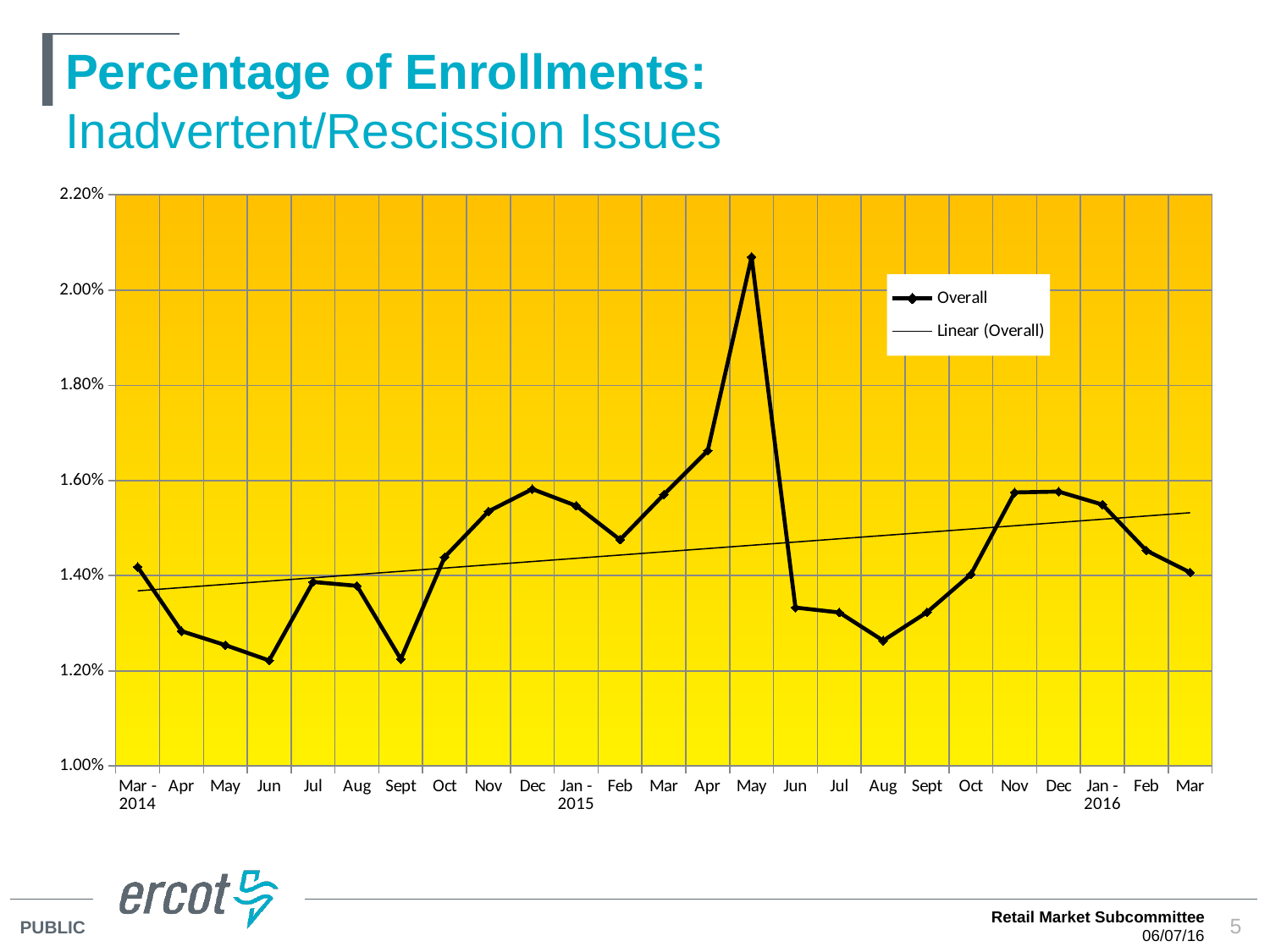
How many monthly data points are plotted on the Overall line? 25 Is the Overall value for Aug 2015 greater or less than 1.40%? less Which is larger, the Overall value for Apr 2015 or for Jun 2015? Apr 2015 How many series does the legend list? 2 Is the Overall value for Apr 2015 greater or less than 1.60%? greater In which month does the Overall line reach its highest value? May 2015 Does the Linear (Overall) trend line rise or fall from left to right? Rises What are the two entries in the chart legend? Overall and Linear (Overall) What kind of chart is shown on the slide? Line chart Is the Overall value for Jun 2014 greater or less than 1.40%? less Which is larger, the Overall value for Dec 2014 or for Feb 2015? Dec 2014